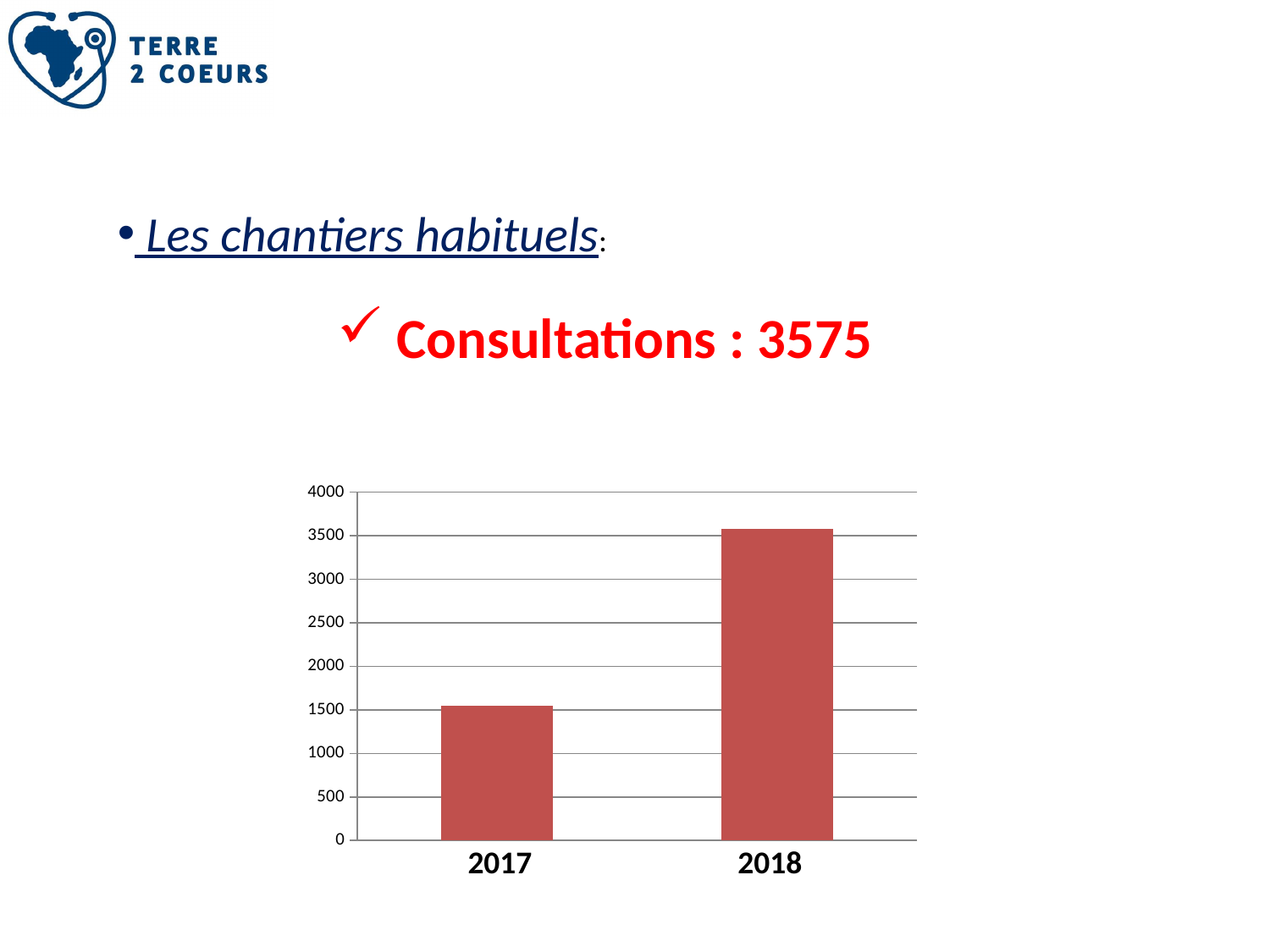
How many categories are shown on the x axis of the chart? 2 What colour are the bars in the chart? red What is the highest value shown on the y axis of the chart? 4000 Which year has the highest bar in the chart? 2018 Is the value for 2018 greater or less than 4000? less Do the values rise or fall from 2017 to 2018? rise Which is larger, the value for 2017 or the value for 2018? 2018 Is the value for 2017 greater or less than 2000? less What kind of chart is shown on the slide? bar chart Is the value for 2018 greater or less than 3500? greater Which year has the lowest bar in the chart? 2017